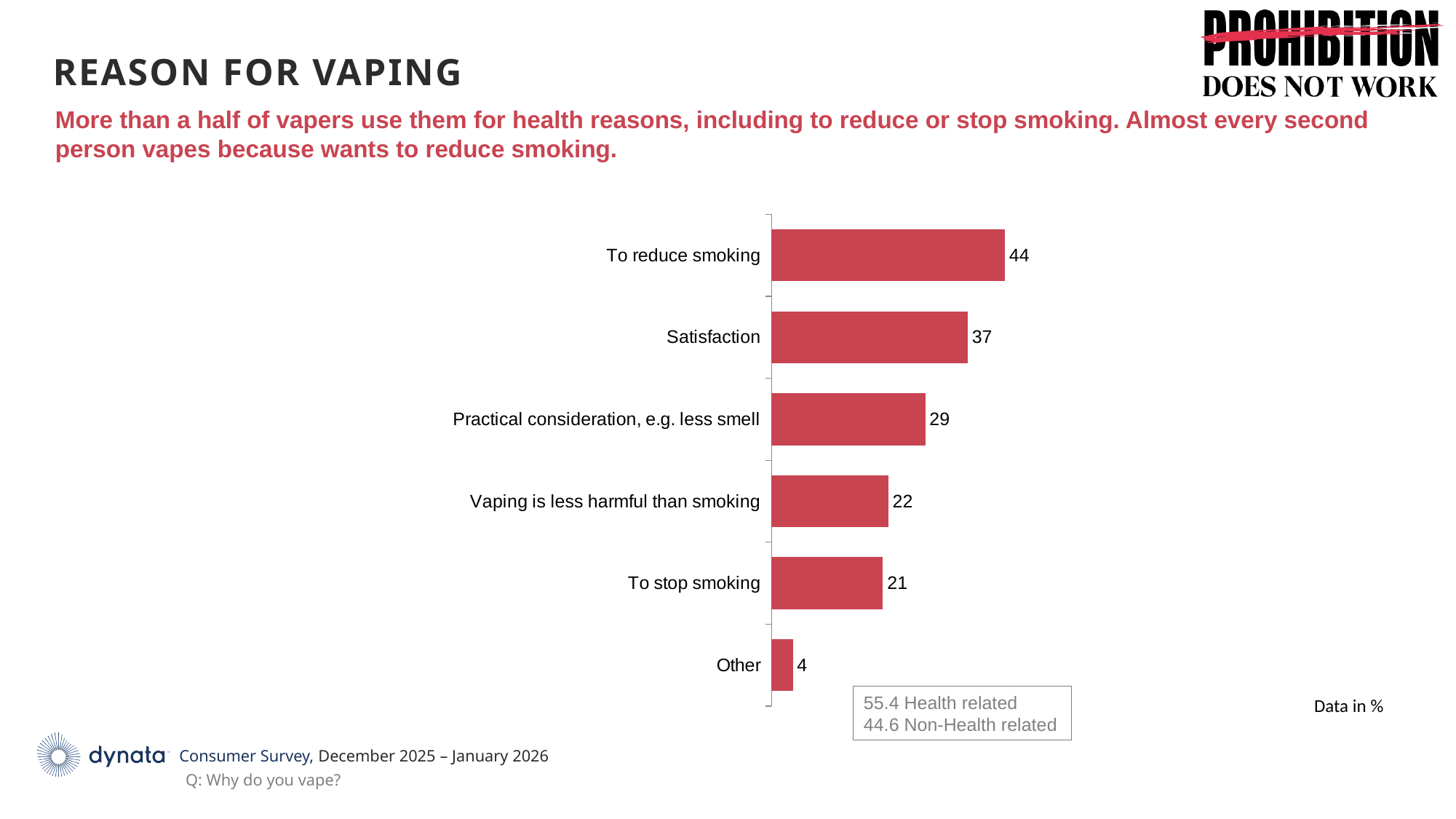
What kind of chart is shown on the slide? Bar chart What is the value for "Satisfaction"? 37 What is the value for "Practical consideration, e.g. less smell"? 29 What is the difference between the values for "Vaping is less harmful than smoking" and "Other"? 18 Which reason has the highest value? To reduce smoking Which is larger: the value for "Practical consideration, e.g. less smell" or the value for "Vaping is less harmful than smoking"? Practical consideration, e.g. less smell How many reasons (categories) are shown in the chart? 6 Which reason has the lowest value? Other According to the box below the chart, what share of reasons is health related? 55.4 What is the value for "To stop smoking"? 21 What is the value for "To reduce smoking"? 44 What is the difference between the values for "To reduce smoking" and "Satisfaction"? 7